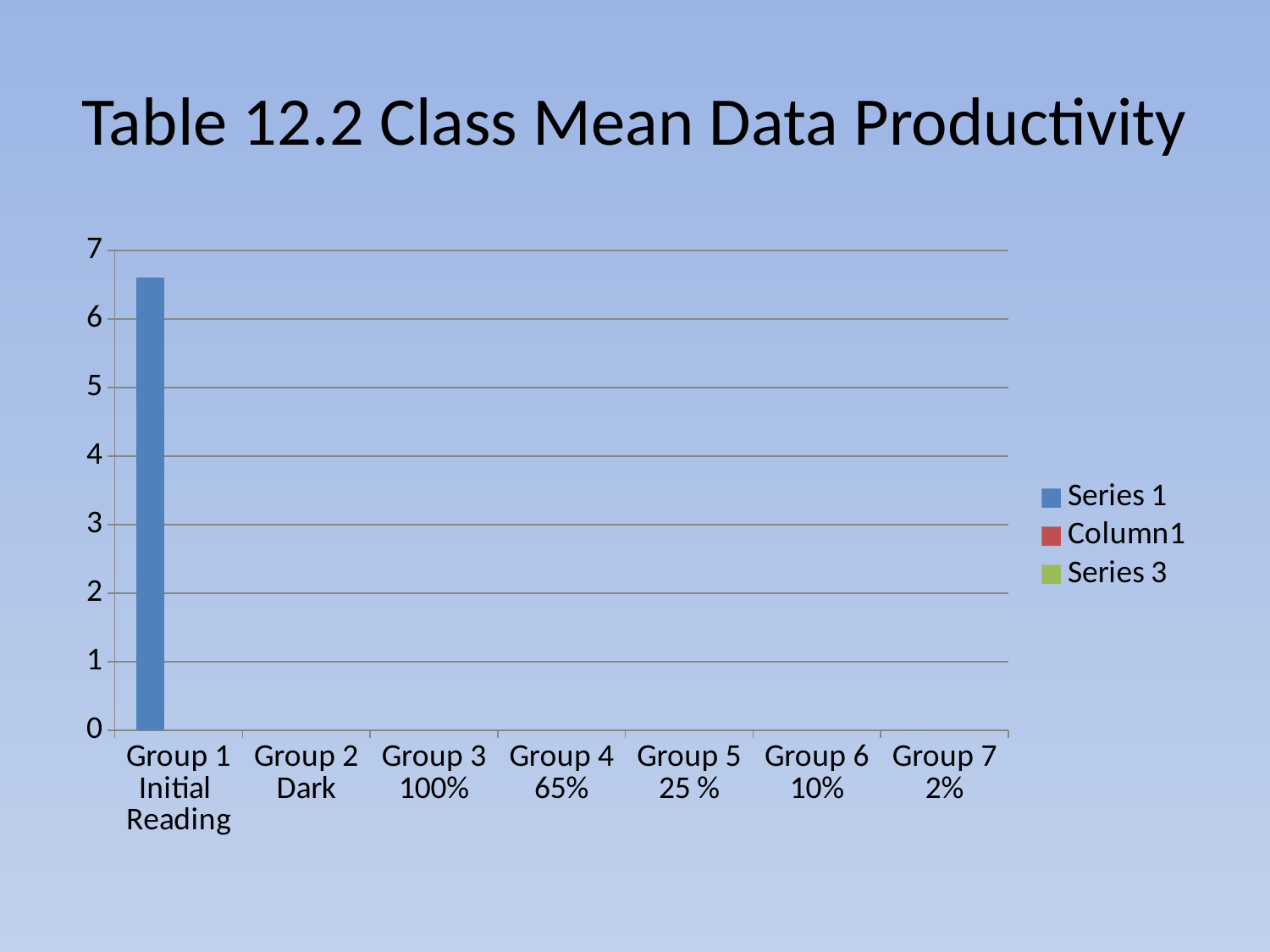
What kind of chart is shown on the slide? bar chart What is the title of the slide containing the chart? Table 12.2 Class Mean Data Productivity What is the highest value shown on the chart's vertical axis? 7 What is the label of the last category on the x axis? Group 7 2% Is the value for Group 1 Initial Reading greater or less than 7? less Is the value for Group 1 Initial Reading greater or less than 6? greater Which category has the highest bar in the chart? Group 1 Initial Reading What are the three entries listed in the chart's legend? Series 1, Column1, Series 3 How many categories are shown along the x axis of the chart? 7 Is the value for Group 1 Initial Reading greater or less than 5? greater How many series does the chart's legend list? 3